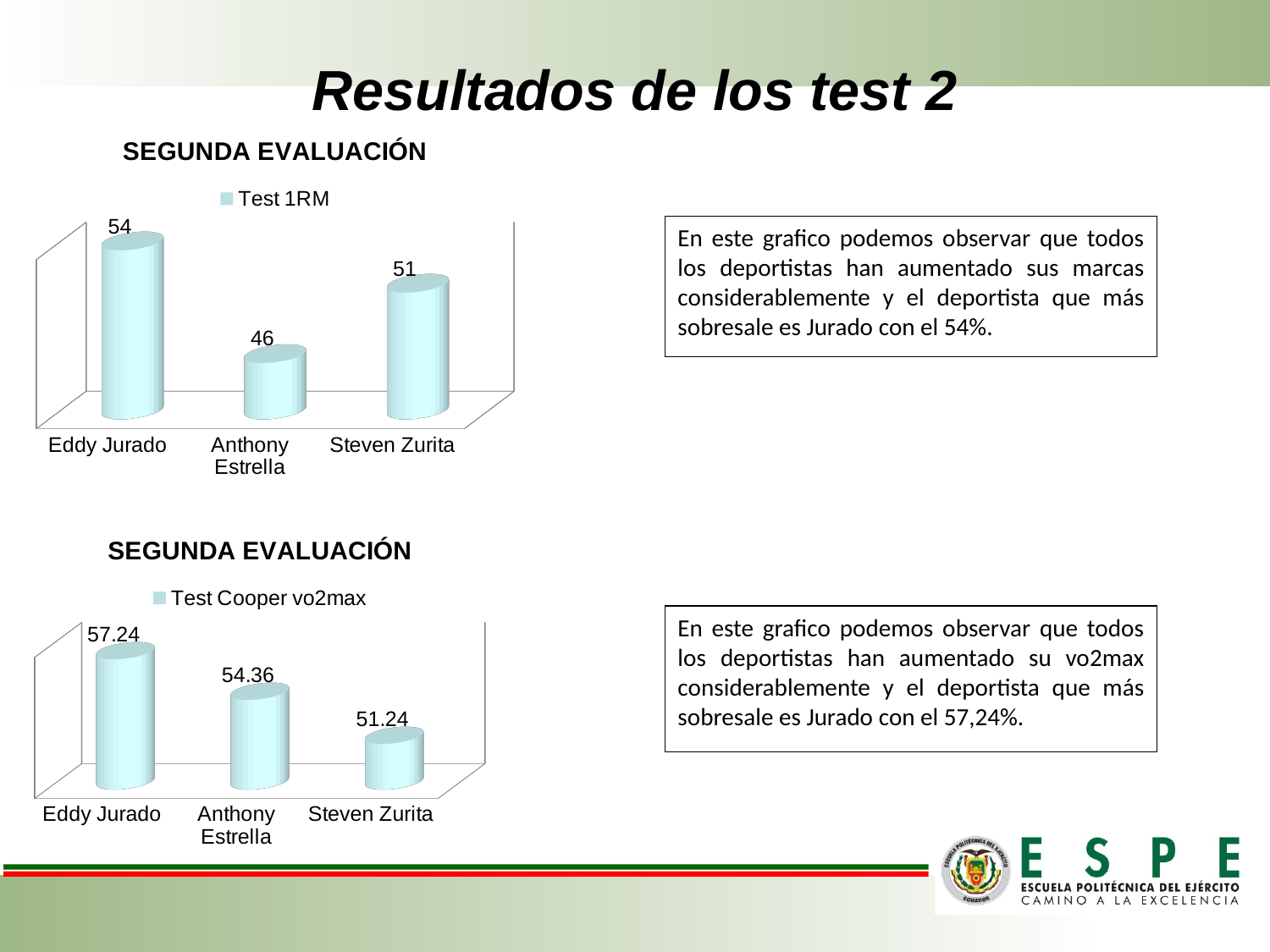
In the top chart (Test 1RM), which athlete has the lowest value? Anthony Estrella What kind of chart is the top chart (Test 1RM)? bar chart In the bottom chart (Test Cooper vo2max), what is the value for Anthony Estrella? 54.36 What series name does the legend of the bottom chart show? Test Cooper vo2max In the bottom chart (Test Cooper vo2max), which athlete has the highest value? Eddy Jurado In the top chart (Test 1RM), what is the value for Eddy Jurado? 54 In the bottom chart (Test Cooper vo2max), do the values rise or fall from left to right? fall In the top chart (Test 1RM), what is the difference between Eddy Jurado's and Steven Zurita's values? 3 In the top chart (Test 1RM), how many athletes are shown? 3 In the bottom chart (Test Cooper vo2max), is the value for Eddy Jurado or Steven Zurita larger? Eddy Jurado In the bottom chart (Test Cooper vo2max), what is the value for Steven Zurita? 51.24 In the top chart (Test 1RM), what is the value for Anthony Estrella? 46